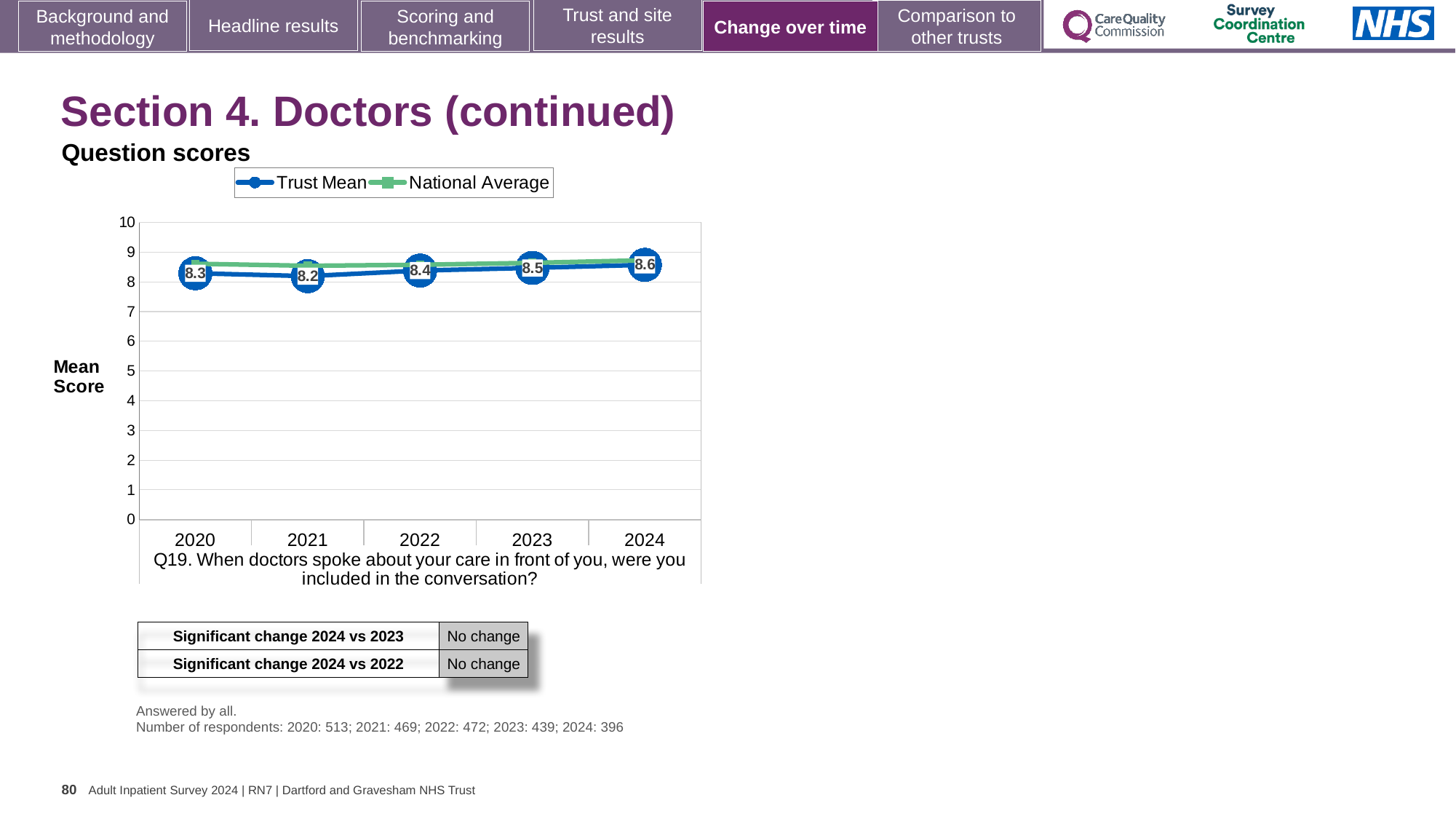
Does the Trust Mean rise or fall from 2021 to 2024? rise What kind of chart is shown? line chart How many series does the legend list? 2 Is the Trust Mean higher in 2023 or in 2022? 2023 How many years are shown on the x axis? 5 What is the difference between the Trust Mean in 2024 and in 2021? 0.4 Is the National Average for 2020 greater or less than 8? greater What is the Trust Mean for 2024? 8.6 What is the Trust Mean for 2020? 8.3 Which year has the lowest Trust Mean? 2021 What is the Trust Mean for 2021? 8.2 Which year has the highest Trust Mean? 2024